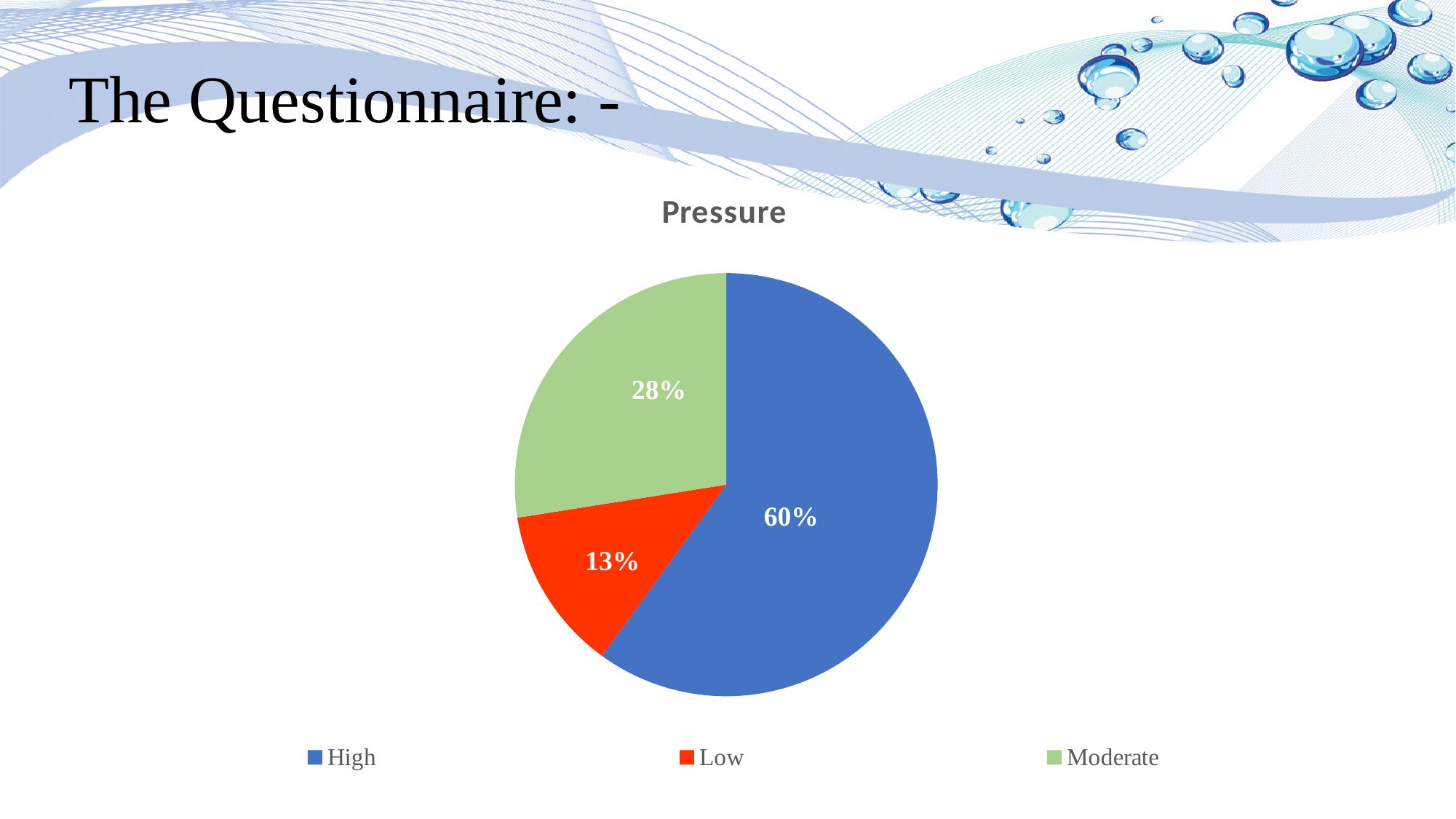
What kind of chart is shown on the slide? pie chart What share of the pie does the High slice take? 60% What share of the pie does the Moderate slice take? 28% Which category has the smallest slice of the pie? Low What is the title of the chart? Pressure Which is larger, the Moderate slice or the Low slice? Moderate How many categories does the pie chart show? 3 What share of the pie does the Low slice take? 13% What is the difference between the Moderate and Low shares? 15% Which category has the largest slice of the pie? High What is the difference between the High and Moderate shares? 32% Which colour represents the Low category in the legend? red